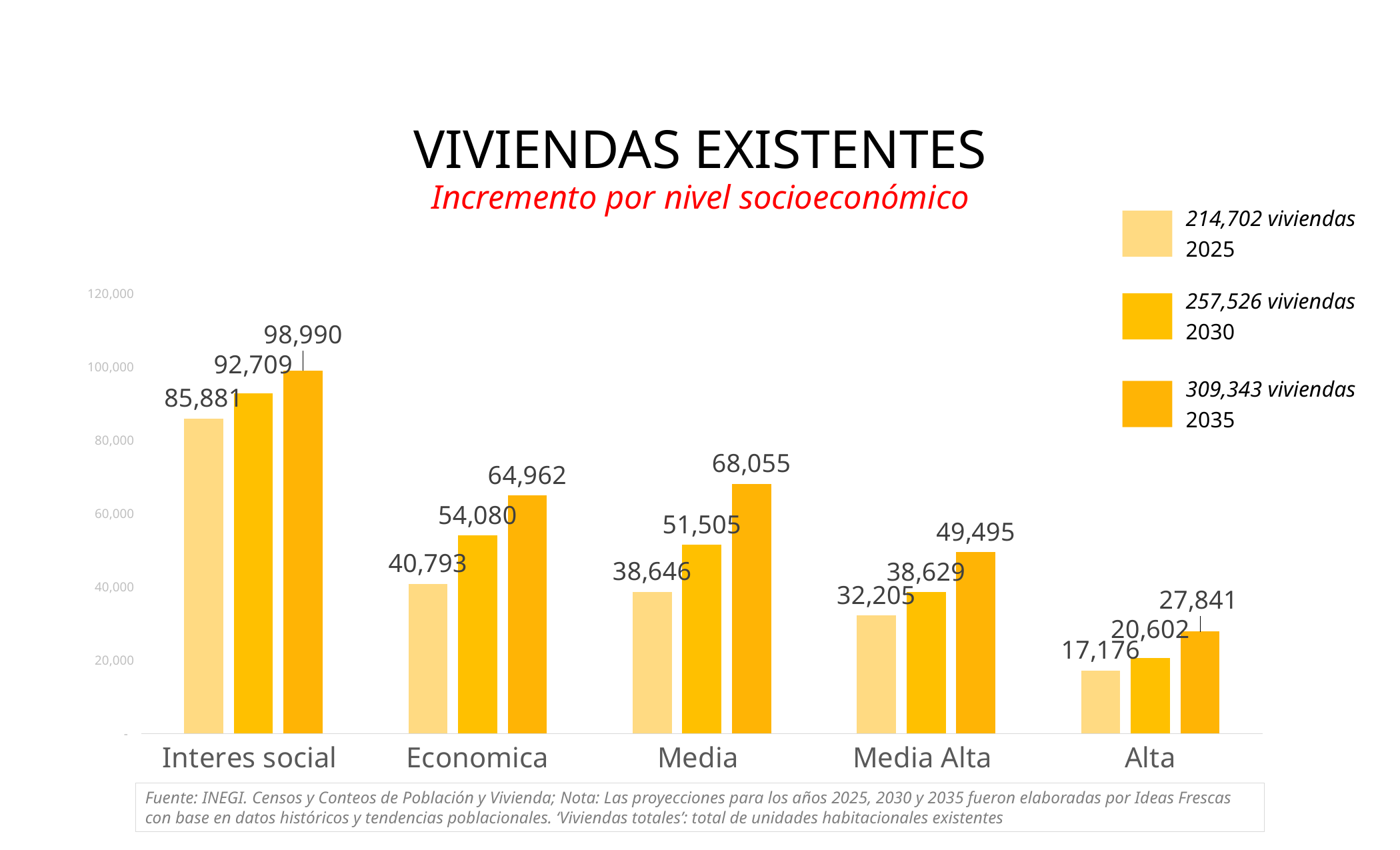
What is the value for Alta in 2035? 27,841 What kind of chart is shown? Bar chart What is the value for Interes social in 2035? 98,990 Which is larger, the 2035 value for Economica or the 2035 value for Media? Media Which category has the lowest value in 2025? Alta What is the difference between the 2035 and 2025 values for Media Alta? 17,290 Which category has the highest value in 2030? Interes social Do the values for Alta rise or fall from 2025 to 2035? Rise What is the value for Economica in 2025? 40,793 How many series does the legend list? 3 What is the value for Media in 2030? 51,505 How many categories are shown on the x axis? 5